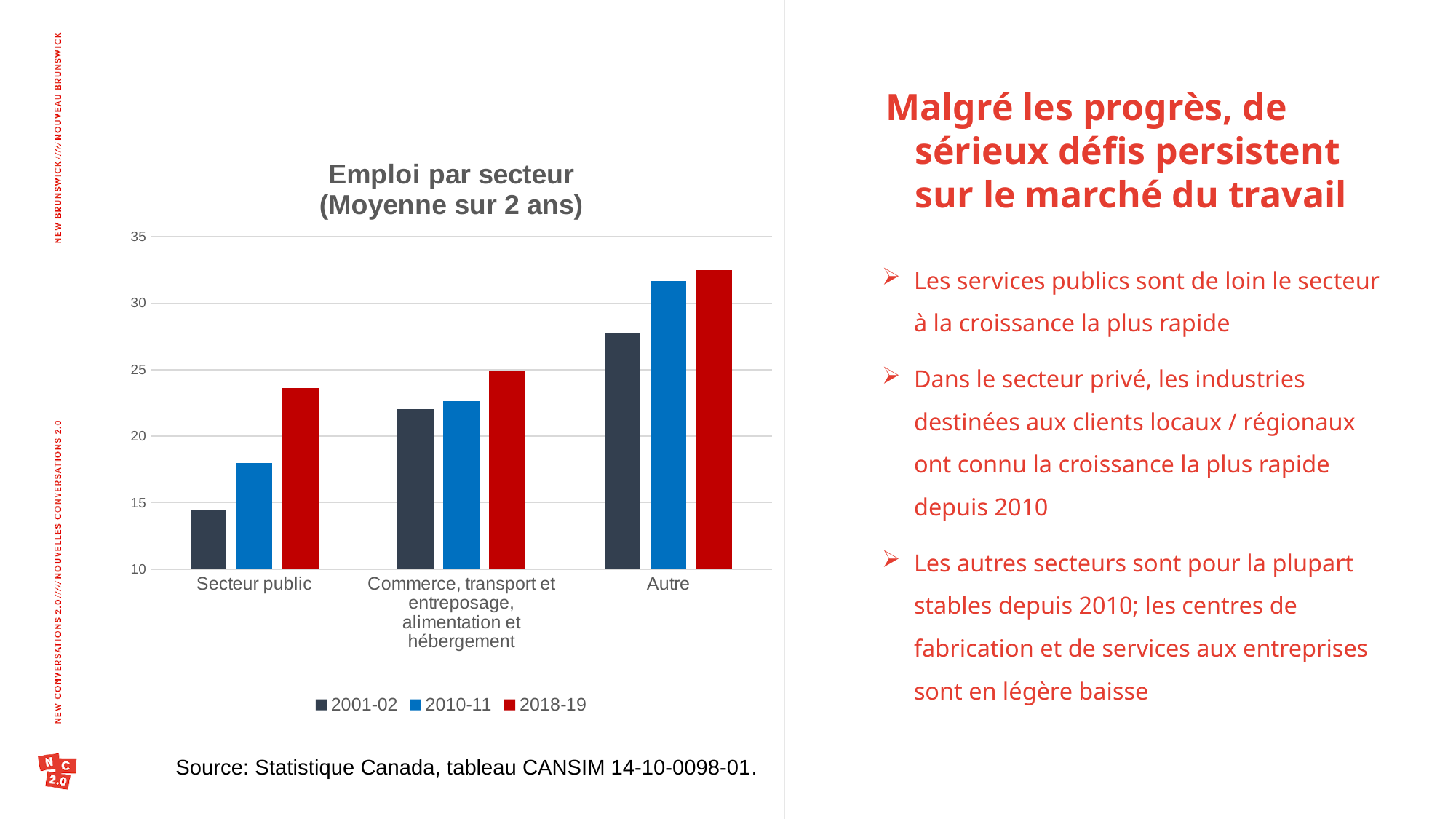
How many sector categories are shown on the x axis? 3 How many series does the legend list? 3 Is the 2010-11 value for Secteur public greater or less than 20? less What kind of chart is shown on the slide? bar chart For Secteur public, do the values rise or fall from 2001-02 to 2018-19? rise Which colour represents the 2018-19 series in the legend? red Is the 2001-02 value for Secteur public greater or less than 20? less Is the 2018-19 value for Commerce, transport et entreposage, alimentation et hébergement greater or less than 20? greater Which sector has the highest value for 2018-19? Autre What is the title of the chart? Emploi par secteur (Moyenne sur 2 ans) Which sector has the lowest value for 2001-02? Secteur public